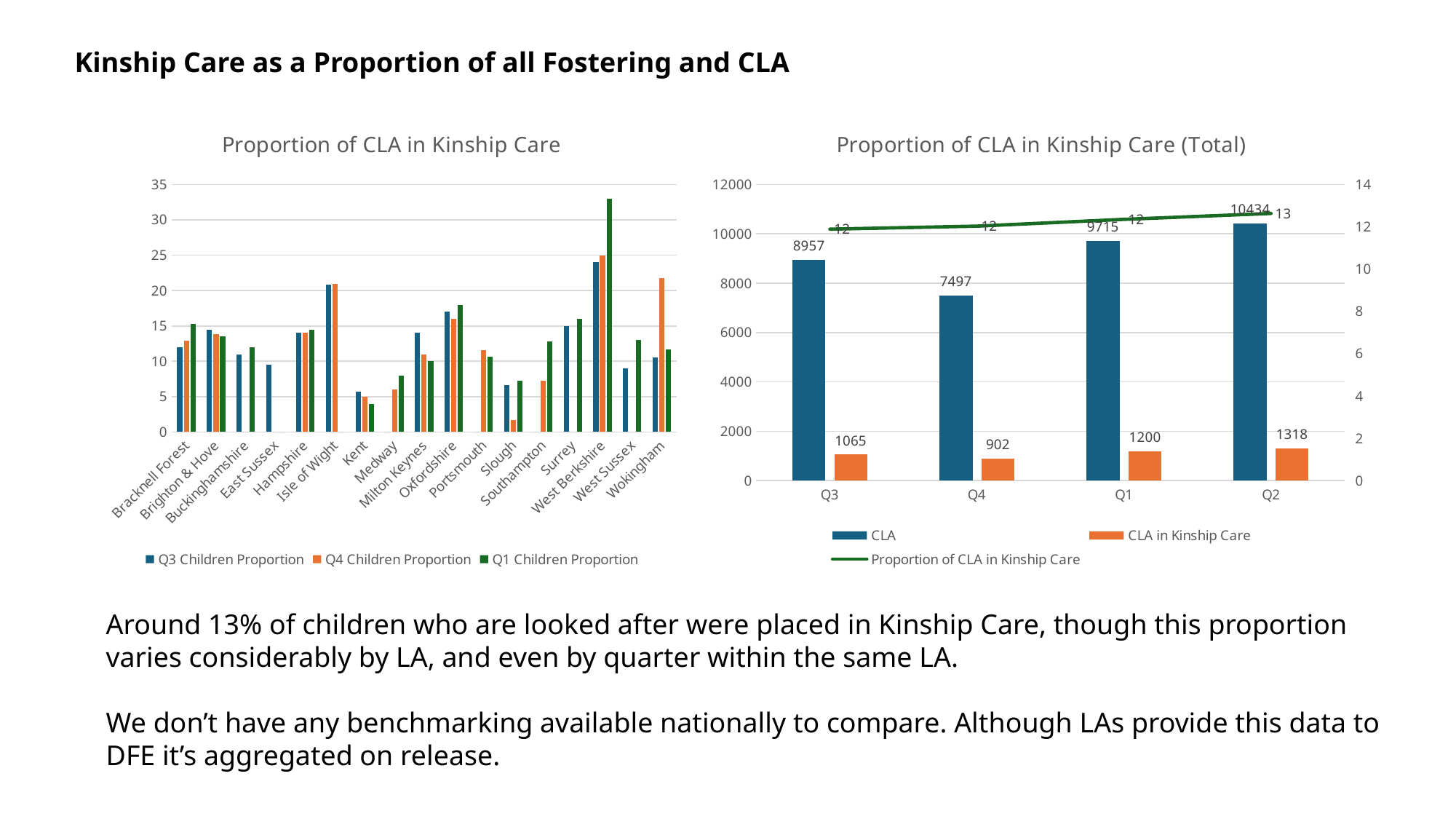
In the 'Proportion of CLA in Kinship Care (Total)' chart, what is the CLA in Kinship Care value for Q4? 902 How many local authorities are shown on the x axis of the 'Proportion of CLA in Kinship Care' chart on the left? 17 In the 'Proportion of CLA in Kinship Care (Total)' chart, what is the difference between the CLA values for Q1 and Q4? 2218 In the left chart, 'Proportion of CLA in Kinship Care', which local authority has the highest Q1 Children Proportion? West Berkshire How many series does the legend of the 'Proportion of CLA in Kinship Care (Total)' chart list? 3 How many series does the legend of the left chart, 'Proportion of CLA in Kinship Care', list? 3 In the 'Proportion of CLA in Kinship Care (Total)' chart, what is the CLA value for Q2? 10434 In the 'Proportion of CLA in Kinship Care (Total)' chart, which quarter has the lowest CLA in Kinship Care value? Q4 In the 'Proportion of CLA in Kinship Care (Total)' chart, what is the Proportion of CLA in Kinship Care value for Q2? 13 In the 'Proportion of CLA in Kinship Care (Total)' chart, which quarter has the highest CLA value? Q2 In the left chart, 'Proportion of CLA in Kinship Care', is the Q3 Children Proportion for Isle of Wight greater or less than 15? greater In the 'Proportion of CLA in Kinship Care (Total)' chart, is the CLA in Kinship Care value larger for Q1 or Q2? Q2